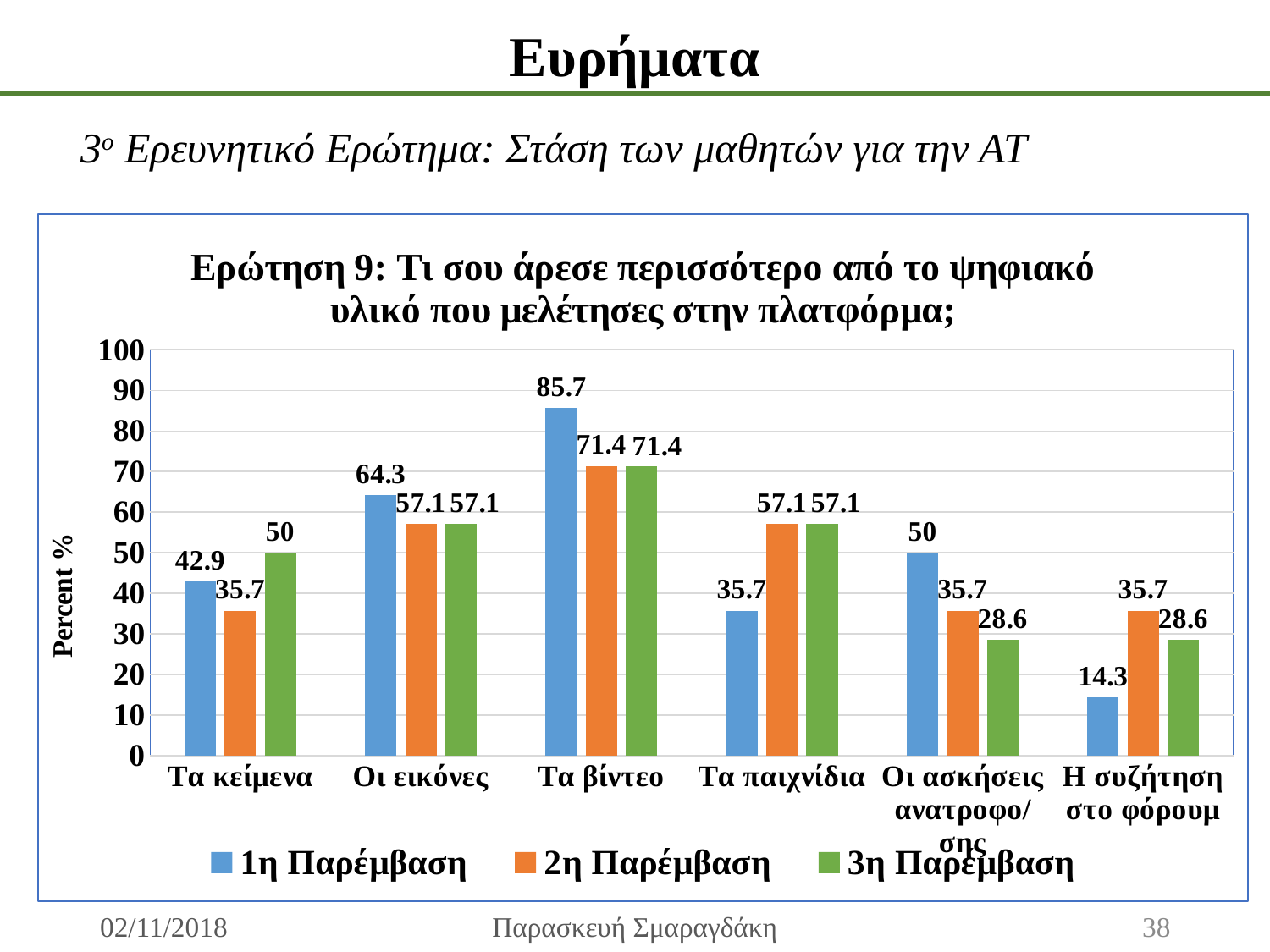
What type of chart is shown on the slide? bar chart Which is larger for Τα παιχνίδια: the 1η Παρέμβαση value or the 2η Παρέμβαση value? 2η Παρέμβαση What is the value for Η συζήτηση στο φόρουμ in the 1η Παρέμβαση series? 14.3 What is the value for Τα παιχνίδια in the 2η Παρέμβαση series? 57.1 How many series does the legend list? 3 What is the value for Τα βίντεο in the 1η Παρέμβαση series? 85.7 What is the difference between the 3η Παρέμβαση values for Τα κείμενα and Οι ασκήσεις ανατροφο/σης? 21.4 What is the difference between the 1η Παρέμβαση and 2η Παρέμβαση values for Τα βίντεο? 14.3 How many categories are shown on the x axis? 6 Which category has the highest value in the 1η Παρέμβαση series? Τα βίντεο What is the label of the y axis? Percent % Which category has the lowest value in the 1η Παρέμβαση series? Η συζήτηση στο φόρουμ